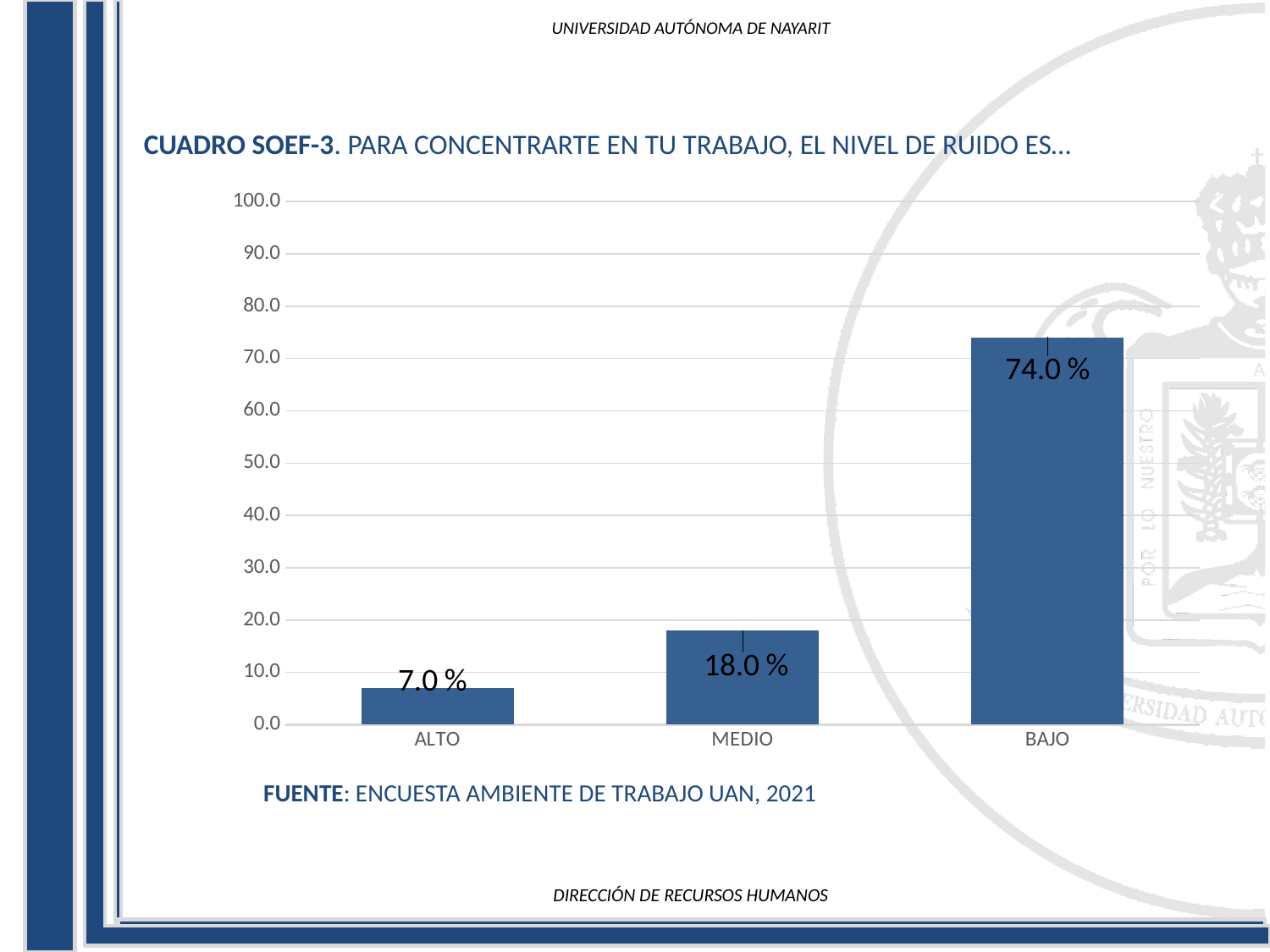
What is the difference between the values for BAJO and MEDIO? 56.0 % What is the difference between the values for MEDIO and ALTO? 11.0 % How many categories are shown on the x axis? 3 What kind of chart is shown on the slide? bar chart What is the value for BAJO? 74.0 % What is the value for MEDIO? 18.0 % Which category has the lowest value? ALTO What source is cited below the chart? ENCUESTA AMBIENTE DE TRABAJO UAN, 2021 Which category has the highest value? BAJO Is the value for BAJO greater or less than 70.0? greater Which is larger, the value for MEDIO or the value for ALTO? MEDIO What is the value for ALTO? 7.0 %